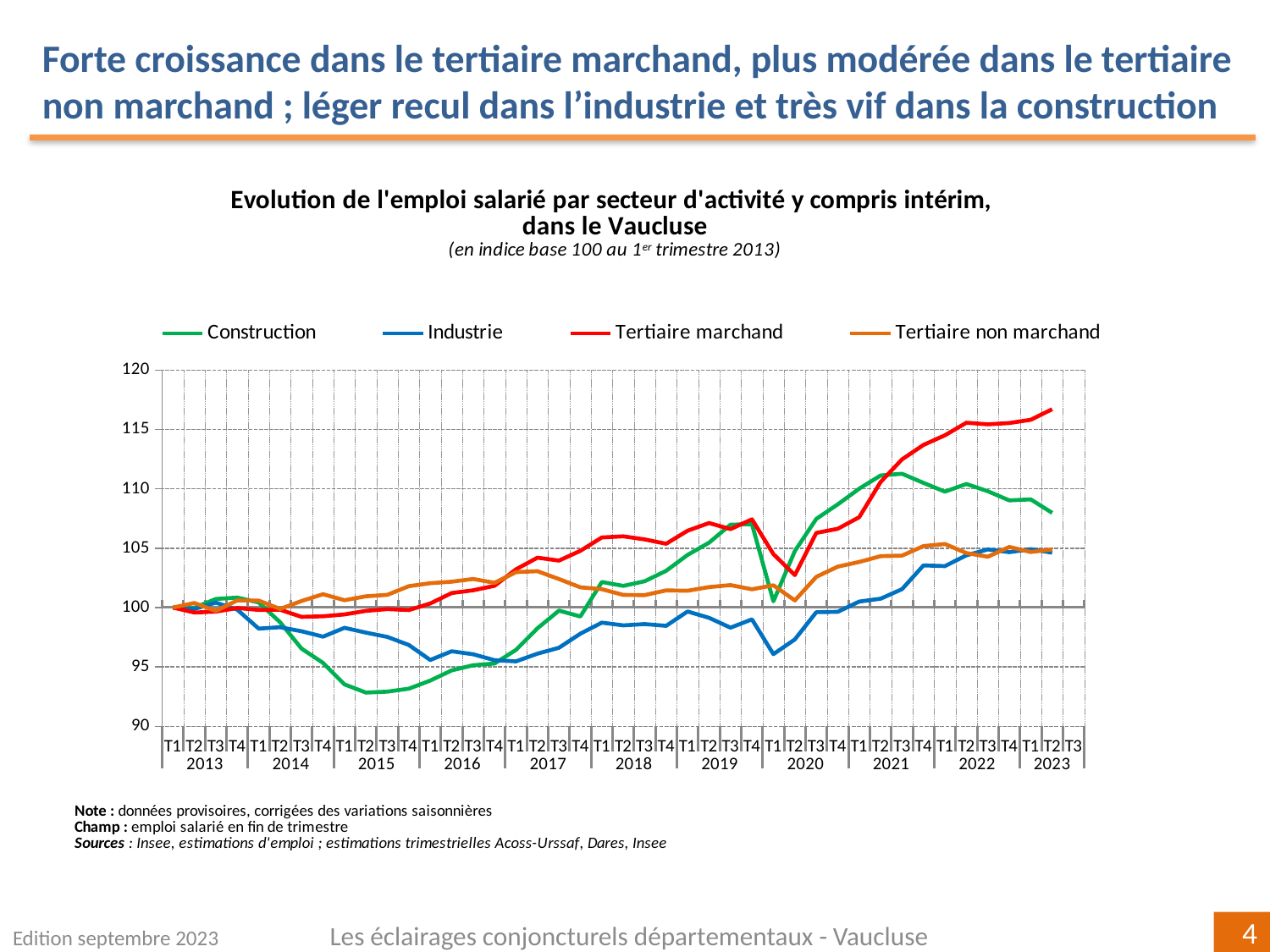
What base index value is used for the chart, according to its subtitle? 100 au 1er trimestre 2013 Which series reaches the highest value on the chart? Tertiaire marchand Is the value for Industrie at T1 2020 greater or less than 100? less Which series falls to the lowest value on the chart? Construction What kind of chart is shown on the slide? line chart Is the value for Construction at T2 2015 greater or less than 95? less At T2 2015, which is larger: Construction or Industrie? Industrie Does the Tertiaire marchand series rise or fall overall from T1 2013 to T3 2023? rise How many series does the legend list? 4 Is the value for Tertiaire marchand at T2 2020 greater or less than 100? greater